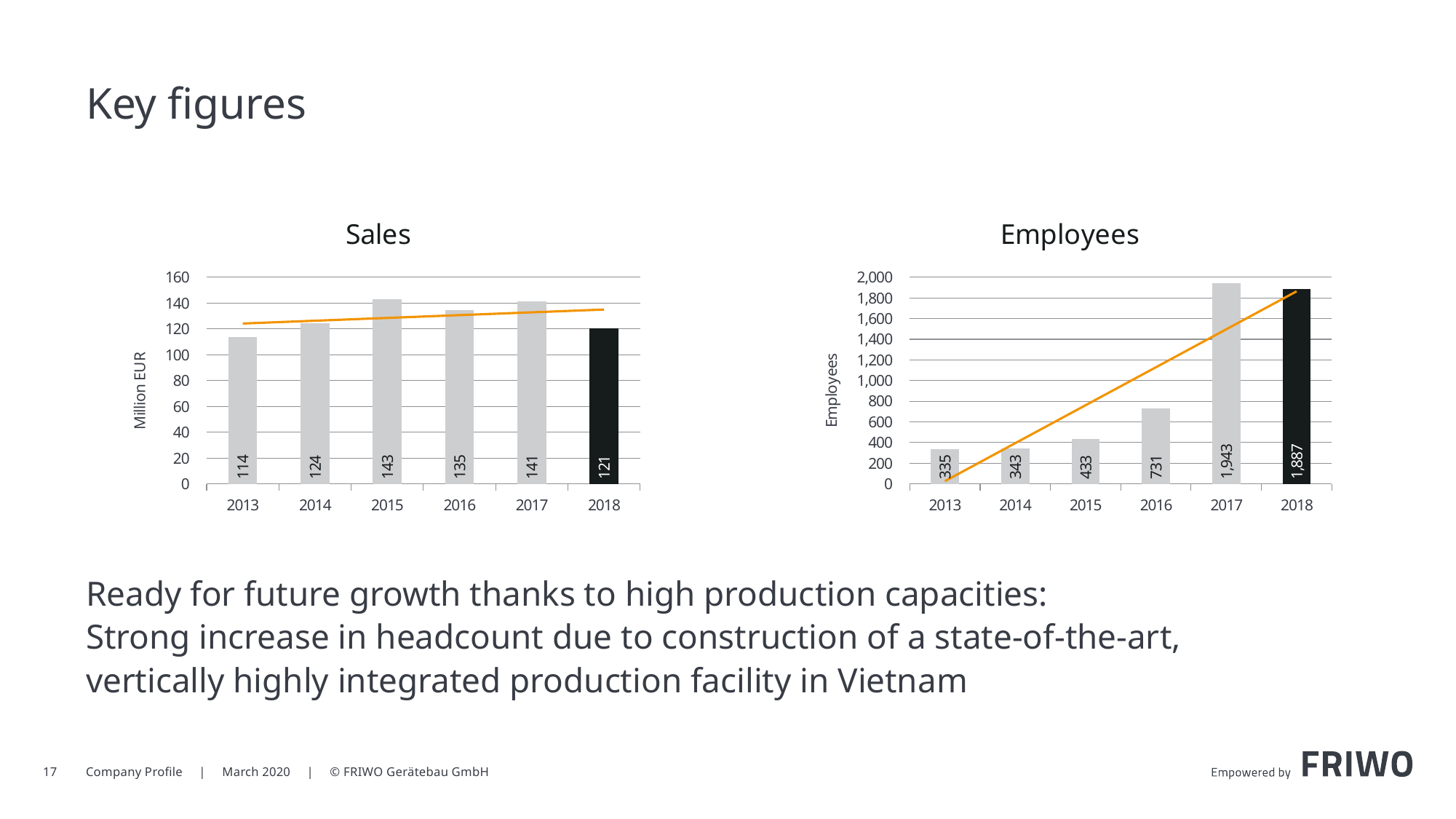
In the Sales chart, what is the difference between the 2017 and 2018 values? 20 In the Employees chart, is the value for 2015 greater or less than 400? greater In the Sales chart, what unit is shown on the y axis label? Million EUR In the Sales chart, how many years are shown on the x axis? 6 In the Employees chart, what is the value for 2016? 731 In the Sales chart, which year has the lowest sales? 2013 What kind of chart is the Employees chart? Bar chart In the Sales chart, what is the value for 2015? 143 In the Employees chart, what is the difference between the 2017 and 2018 values? 56 In the Sales chart, which is larger, the value for 2014 or the value for 2016? 2016 In the Employees chart, which year has the highest number of employees? 2017 In the Employees chart, do the values rise or fall from 2013 to 2017? Rise